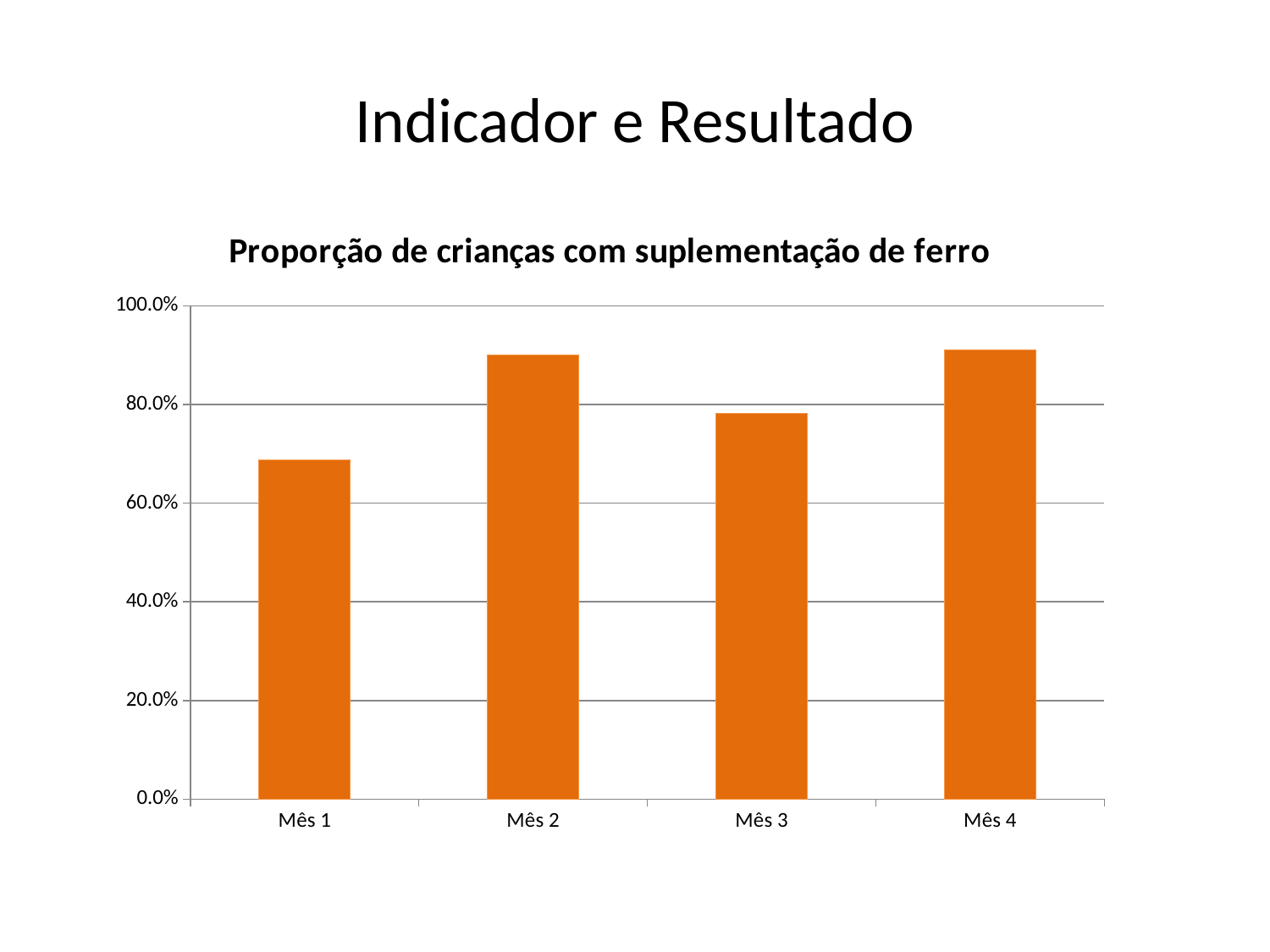
Is the value for Mês 1 greater or less than 60.0%? greater Which is larger, the value for Mês 3 or the value for Mês 4? Mês 4 Is the value for Mês 3 greater or less than 60.0%? greater Which month has the lowest proportion? Mês 1 Is the value for Mês 2 greater or less than 80.0%? greater How many categories (months) are plotted on the chart? 4 Which is larger, the value for Mês 1 or the value for Mês 2? Mês 2 What is the title of the chart? Proporção de crianças com suplementação de ferro What kind of chart is shown on the slide? bar chart What colour are the bars in the chart? orange